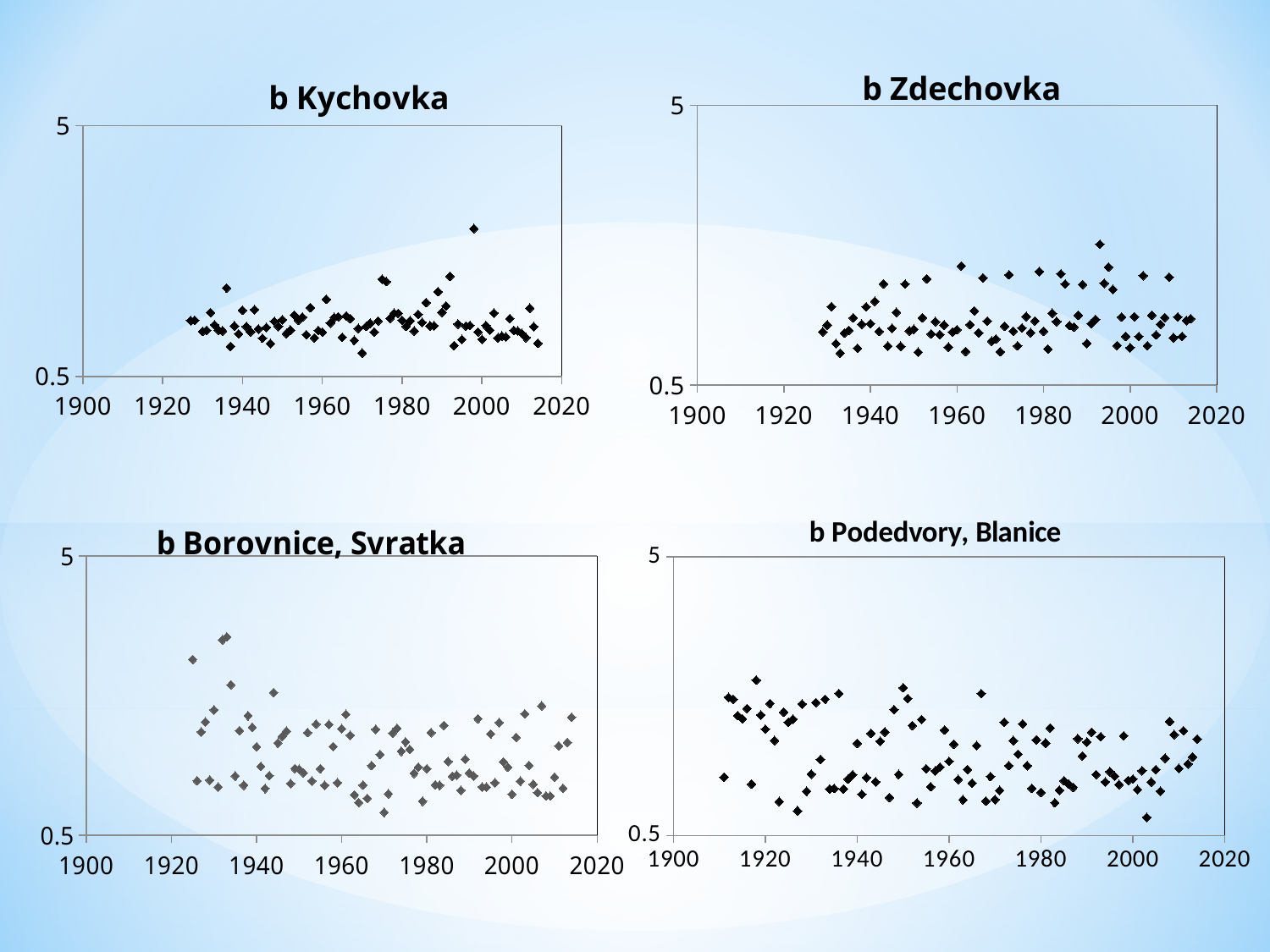
What kind of chart is "b Kychovka"? scatter chart In the "b Podedvory, Blanice" chart, is the lowest plotted point greater or less than 0.5? greater In the "b Kychovka" chart, is the highest plotted point greater or less than 5? less What is the title of the chart in the top-right position? b Zdechovka How many charts are shown on the slide? 4 In the "b Podedvory, Blanice" chart, what is the lowest value shown on the y axis? 0.5 What colour are the data points in the "b Zdechovka" chart? black Which chart has data points starting earliest, before 1920: "b Kychovka" or "b Podedvory, Blanice"? b Podedvory, Blanice In the "b Zdechovka" chart, what is the highest value shown on the y axis? 5 In the "b Borovnice, Svratka" chart, what is the first year label on the x axis? 1900 In the "b Kychovka" chart, what is the last year label on the x axis? 2020 What is the title of the chart in the bottom-left position? b Borovnice, Svratka